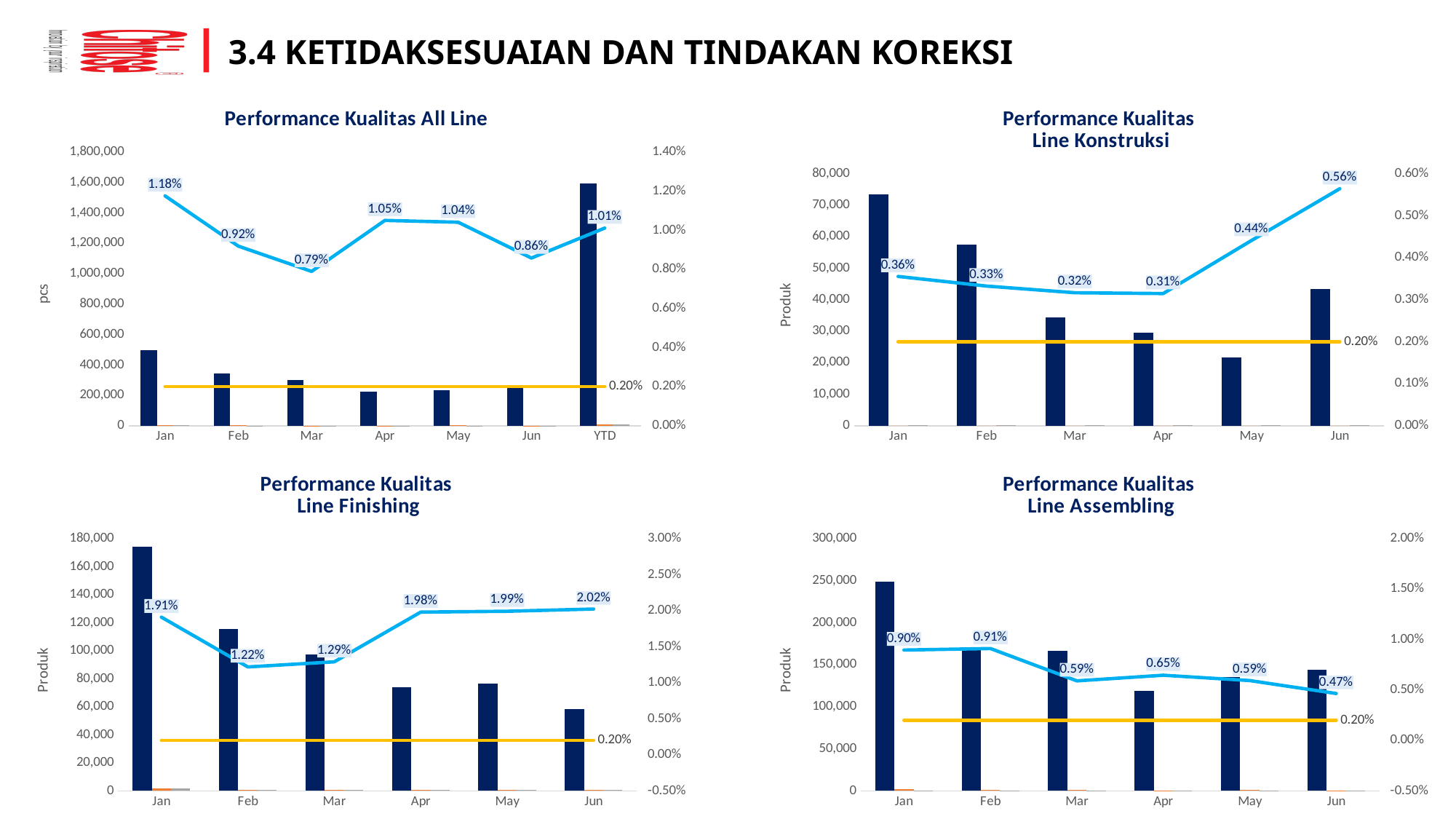
In the 'Performance Kualitas Line Konstruksi' chart, what is the difference between the Jun percentage and the Apr percentage? 0.25% In the 'Performance Kualitas All Line' chart, what is the percentage value shown for Jan? 1.18% In the 'Performance Kualitas Line Assembling' chart, which is larger, the percentage for Feb or the percentage for Jun? Feb In the 'Performance Kualitas Line Konstruksi' chart, is the bar for Jan greater or less than 70,000? greater What value is labelled on the horizontal orange target line in the 'Performance Kualitas Line Assembling' chart? 0.20% In the 'Performance Kualitas Line Konstruksi' chart, what is the percentage value shown for Jun? 0.56% In the 'Performance Kualitas Line Finishing' chart, what is the percentage value shown for Feb? 1.22% In the 'Performance Kualitas Line Finishing' chart, which month has the highest percentage value on the line? Jun In the 'Performance Kualitas Line Finishing' chart, is the bar for Jan greater or less than 160,000? greater In the 'Performance Kualitas All Line' chart, which month has the lowest percentage value on the line? Mar In the 'Performance Kualitas All Line' chart, what is the percentage value shown for YTD? 1.01% In the 'Performance Kualitas Line Assembling' chart, how many months are shown on the x axis? 6